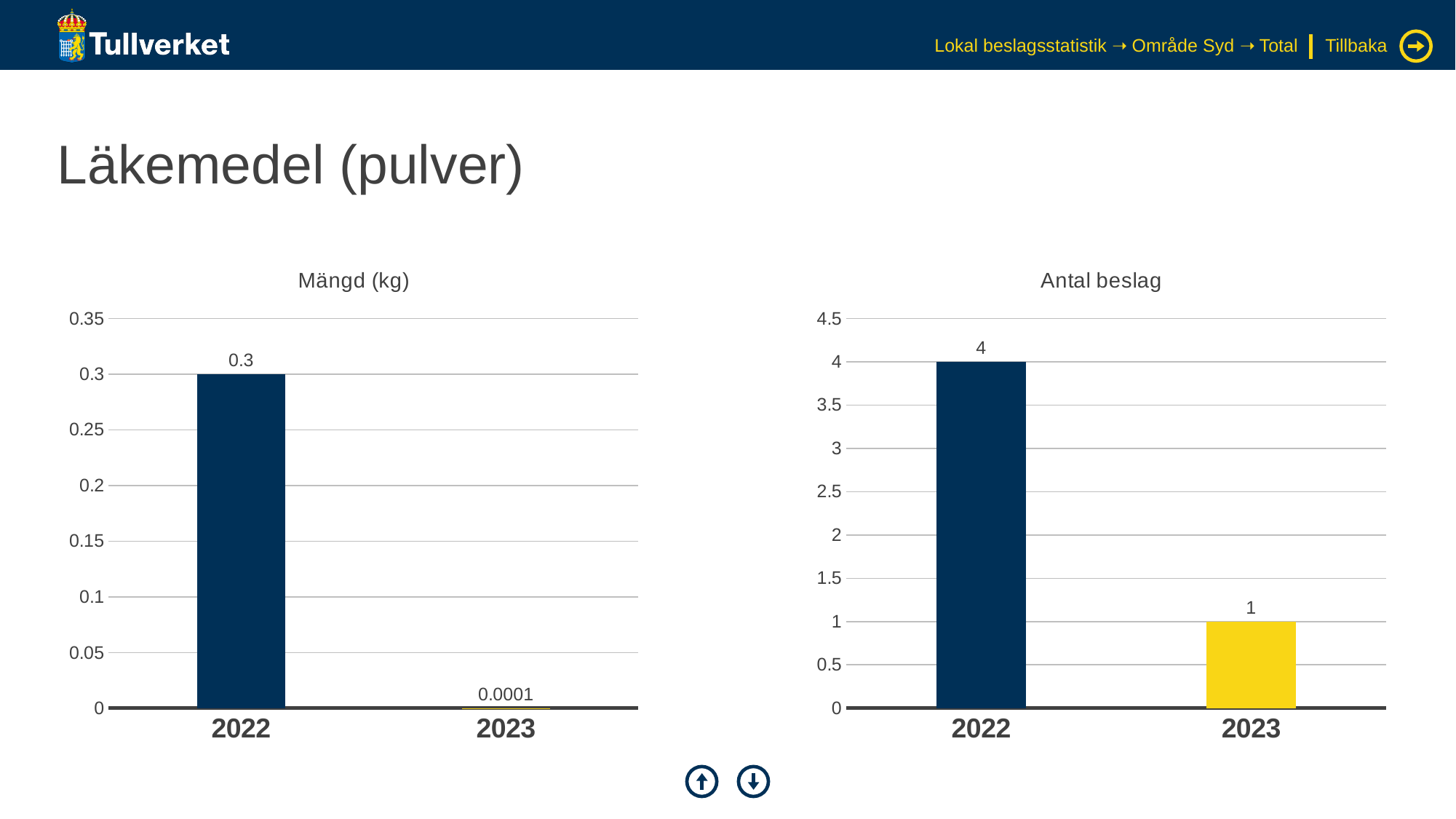
In the "Antal beslag" chart, do the values rise or fall from 2022 to 2023? fall In the "Antal beslag" chart, what is the difference between the values for 2022 and 2023? 3 In the "Mängd (kg)" chart, which year has the larger value, 2022 or 2023? 2022 In the "Antal beslag" chart, what is the value for 2023? 1 In the "Antal beslag" chart, is the value for 2022 greater or less than 3? greater In the "Antal beslag" chart, what is the value for 2022? 4 What kind of chart is the "Antal beslag" chart? bar chart How many years are shown in the "Mängd (kg)" chart? 2 In the "Antal beslag" chart, which year has the highest value? 2022 In the "Mängd (kg)" chart, what is the value for 2023? 0.0001 In the "Mängd (kg)" chart, which year has the lowest value? 2023 In the "Mängd (kg)" chart, what is the value for 2022? 0.3